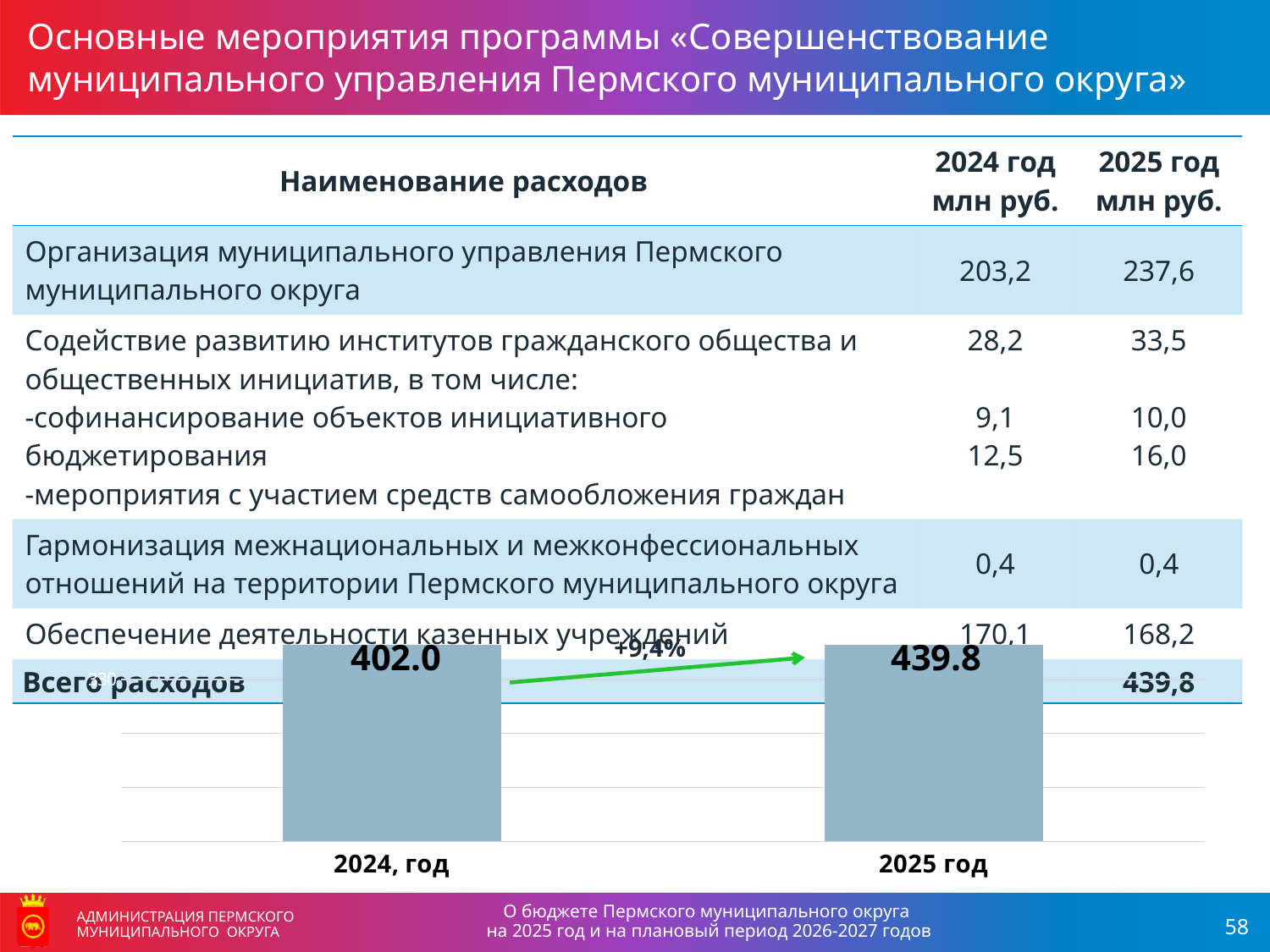
How many bars are plotted in the chart? 2 What percentage change is written next to the arrow between the two bars? +9,4% Which year has the higher bar in the chart? 2025 год Which year has the lower bar in the chart? 2024, год What colour is the arrow connecting the two bars in the chart? green What is the difference between the 2025 год value and the 2024, год value in the bar chart? 37.8 What kind of chart is shown at the bottom of the slide? bar chart What is the value shown for 2024, год in the bar chart? 402.0 What is the value shown for 2025 год in the bar chart? 439.8 Do the values in the chart rise or fall from 2024, год to 2025 год? rise Is the bar for 2025 год larger or smaller than the bar for 2024, год? larger